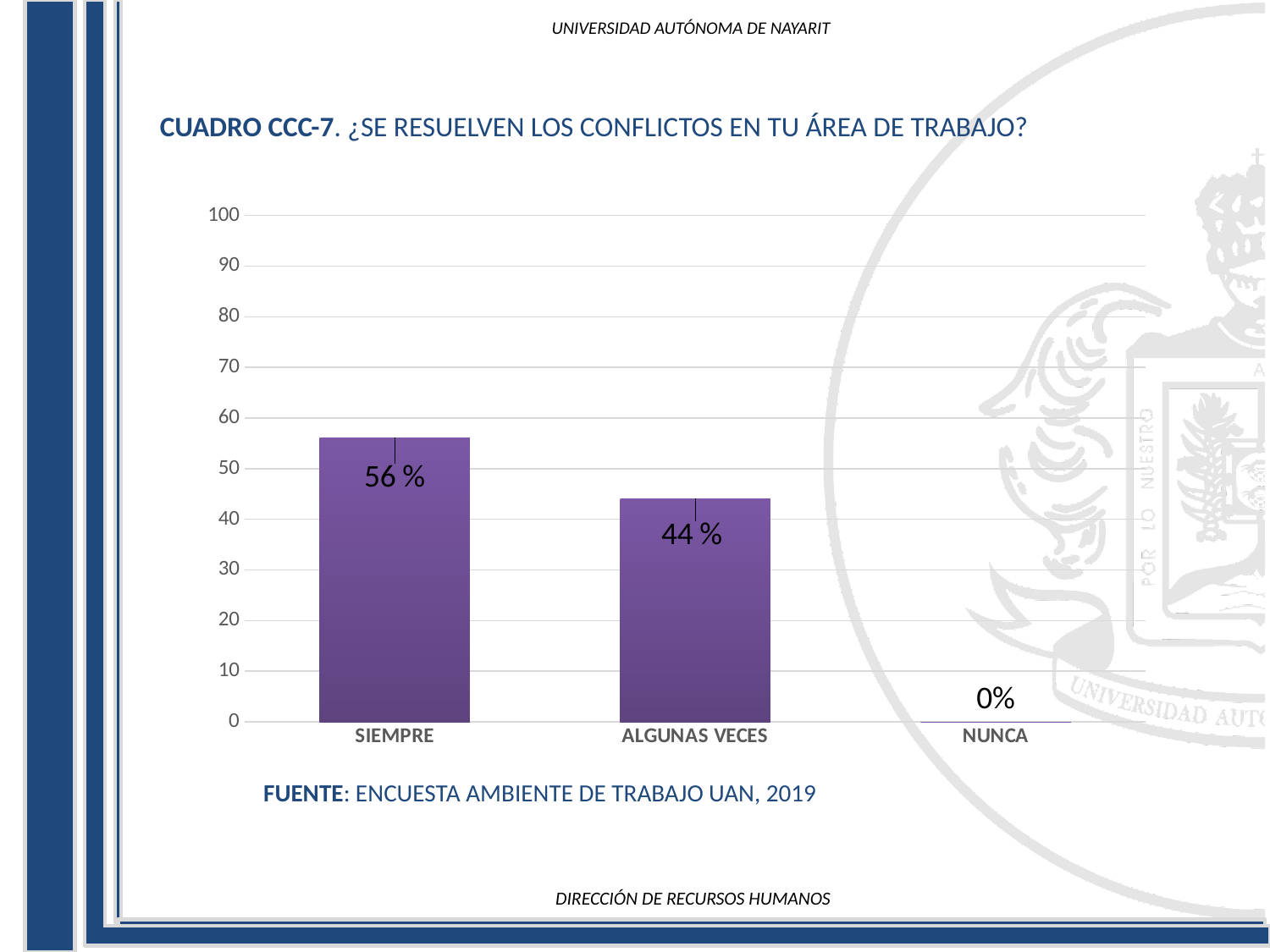
How many categories are shown on the x axis? 3 Which category has the lowest value? NUNCA What is the value for NUNCA? 0% What is the difference between the values for SIEMPRE and ALGUNAS VECES? 12 % Which category has the highest value? SIEMPRE Is the value for ALGUNAS VECES greater or less than 50? less Which is larger, the value for SIEMPRE or the value for ALGUNAS VECES? SIEMPRE What is the value for ALGUNAS VECES? 44 % What is the source cited below the chart? ENCUESTA AMBIENTE DE TRABAJO UAN, 2019 Is the value for SIEMPRE greater or less than 50? greater What kind of chart is shown on the slide? bar chart What is the value for SIEMPRE? 56 %